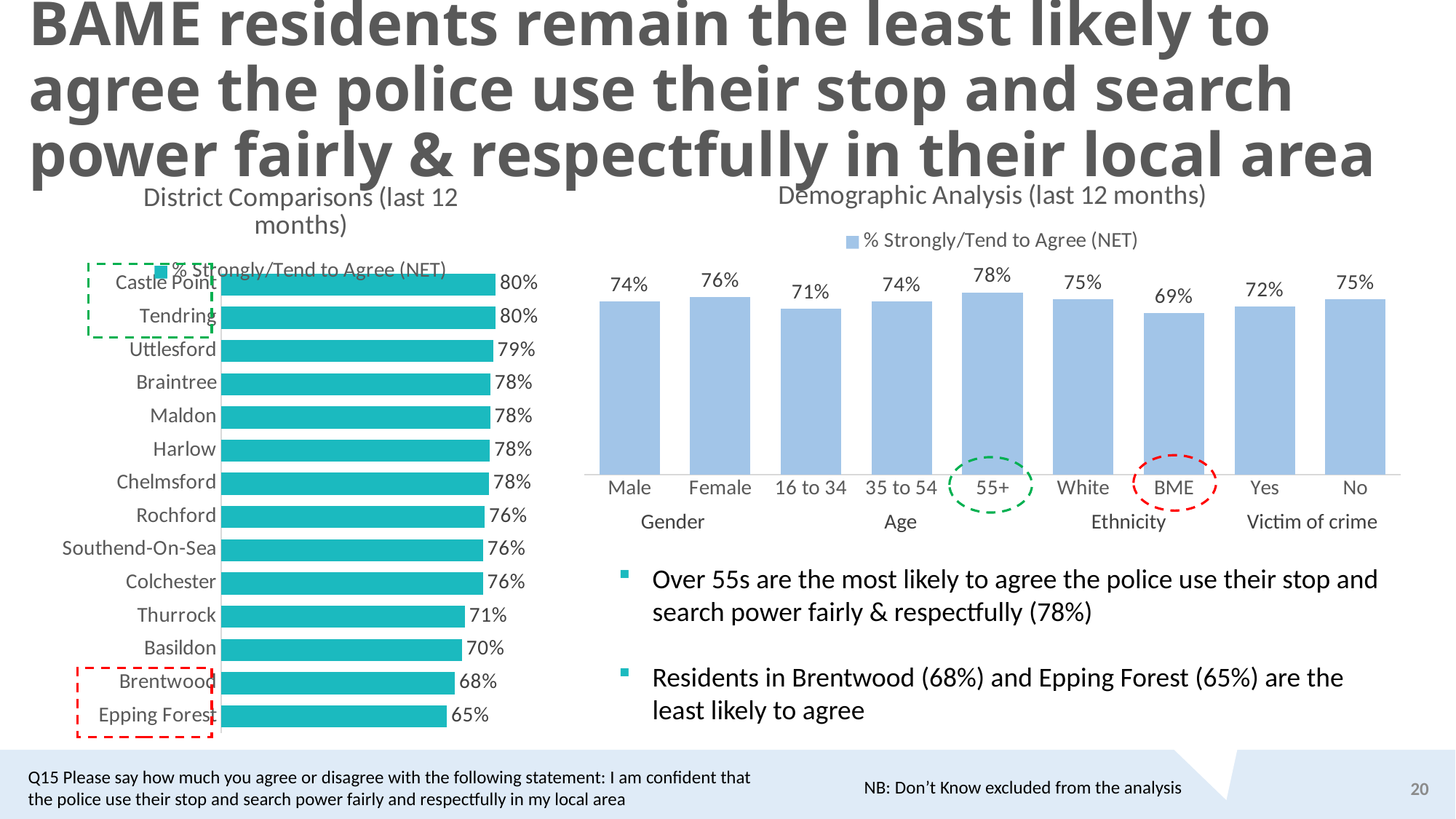
In the District Comparisons chart, how many districts are shown? 14 What kind of chart is the District Comparisons chart? Bar chart In the District Comparisons chart, what is the value for Thurrock? 71% In the District Comparisons chart, which district has the lowest value? Epping Forest What series name does the legend of the Demographic Analysis chart show? % Strongly/Tend to Agree (NET) In the District Comparisons chart, what is the difference between Castle Point and Epping Forest? 15% In the Demographic Analysis chart, which category has the highest value? 55+ In the Demographic Analysis chart, how many categories are plotted? 9 In the Demographic Analysis chart, which is larger, White or BME? White In the Demographic Analysis chart, what is the value for BME? 69% In the Demographic Analysis chart, what is the difference between Female and Male? 2% In the District Comparisons chart, which is larger, Basildon or Rochford? Rochford